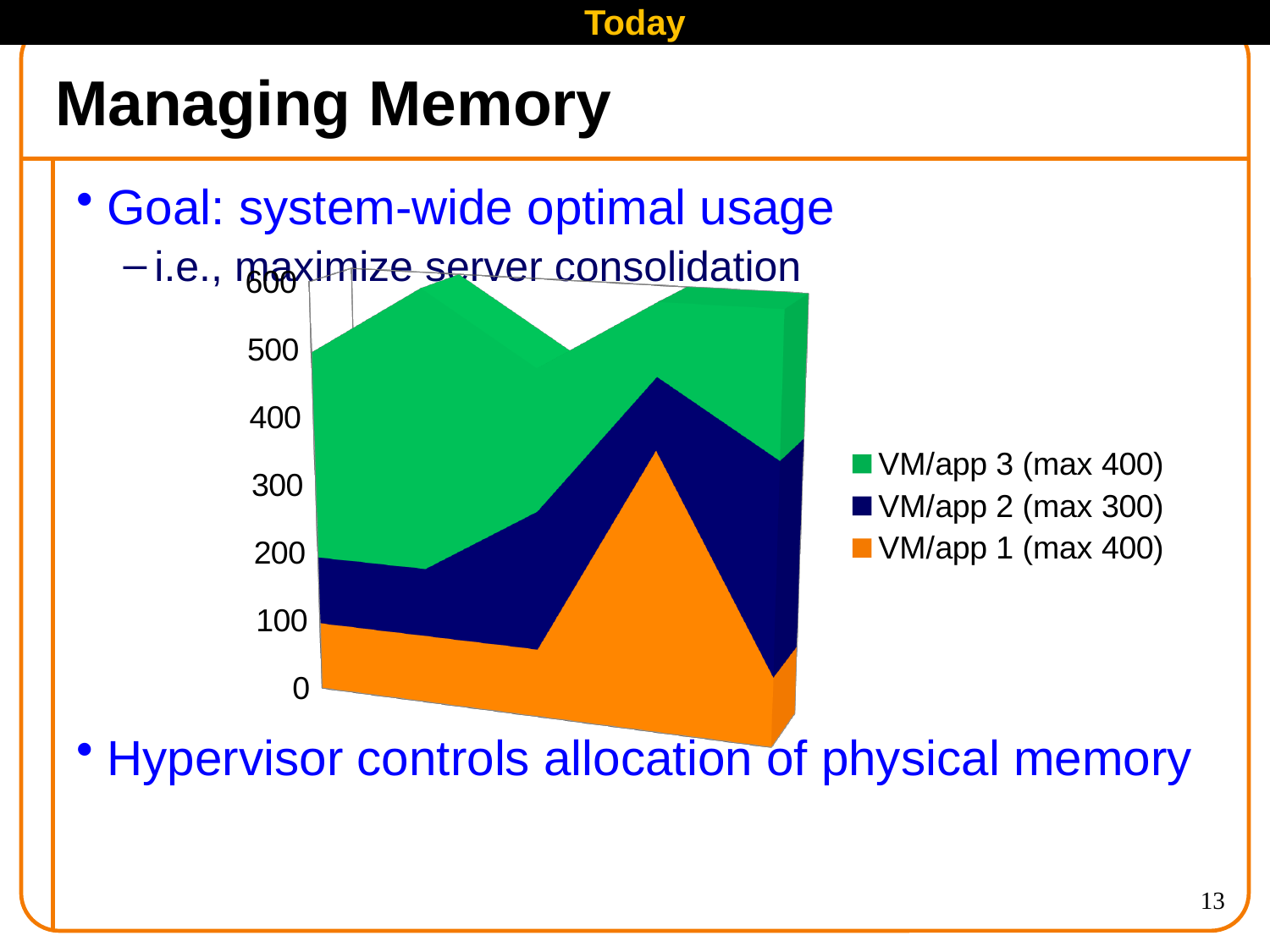
According to the legend, what is the maximum for VM/app 2? 300 Is the first value of VM/app 1 (orange) greater or less than 200? less How many series does the legend list? 3 Which colour represents VM/app 3 in the chart? green Is the peak value of VM/app 1 (orange) greater or less than 300? greater How many data points does each series have along the x axis? 5 What kind of chart is shown on the slide? stacked area chart Is the lowest stacked total across all three series greater or less than 400? greater What is the highest value shown on the vertical axis? 600 Which series is listed first in the legend? VM/app 3 (max 400)